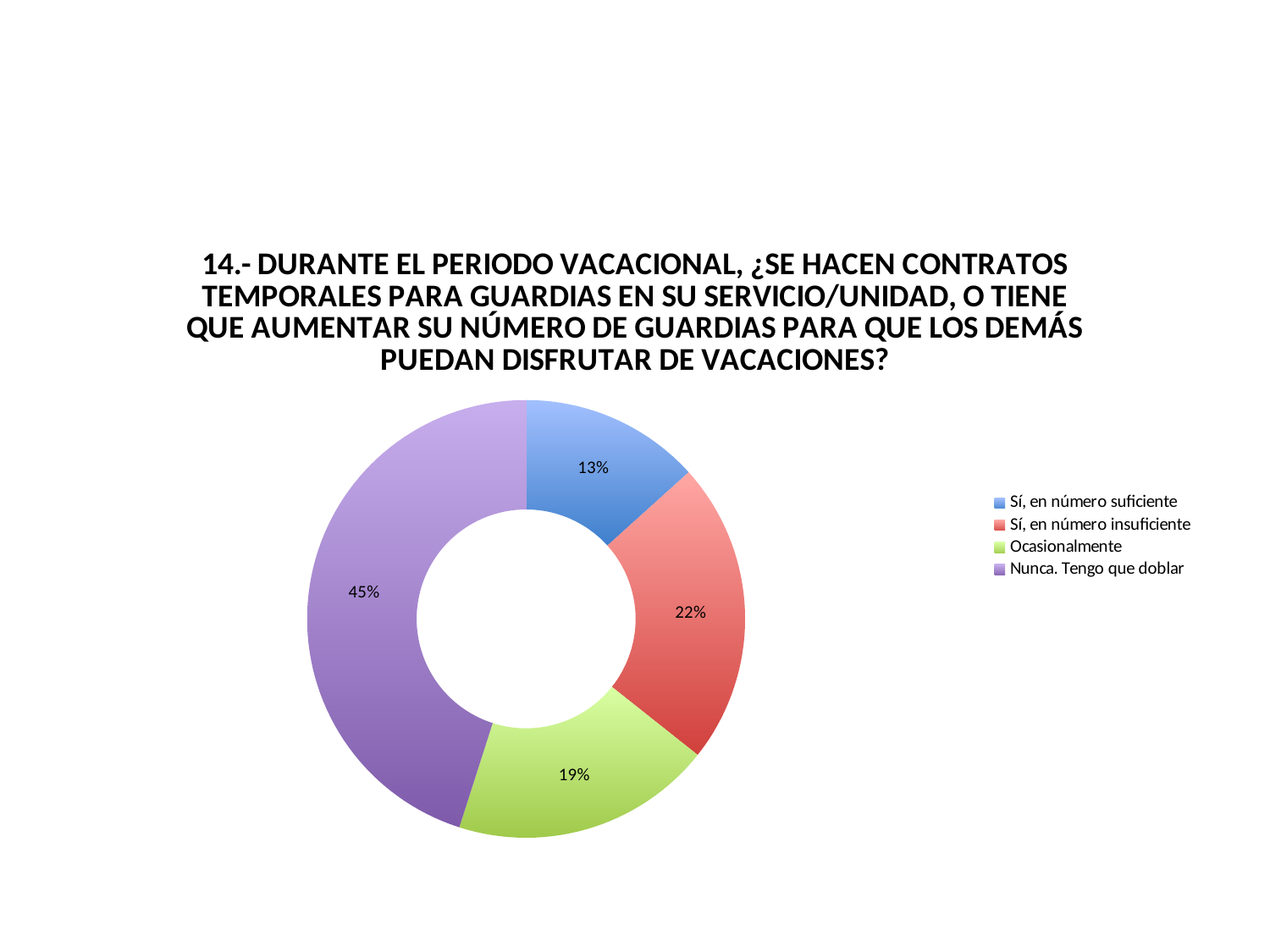
Which category has the largest share of the chart? Nunca. Tengo que doblar Which category has the smallest share of the chart? Sí, en número suficiente What percentage of the chart corresponds to "Sí, en número suficiente"? 13% What percentage of the chart corresponds to "Nunca. Tengo que doblar"? 45% How many categories are shown in the chart? 4 What kind of chart is shown on the slide? Doughnut chart What is the difference in percentage points between "Nunca. Tengo que doblar" and "Sí, en número insuficiente"? 23 Which is larger, the share for "Ocasionalmente" or the share for "Sí, en número insuficiente"? Sí, en número insuficiente What percentage of the chart corresponds to "Sí, en número insuficiente"? 22% What is the combined share of "Sí, en número suficiente" and "Sí, en número insuficiente"? 35% What percentage of the chart corresponds to "Ocasionalmente"? 19% What colour is the slice for "Ocasionalmente"? Green